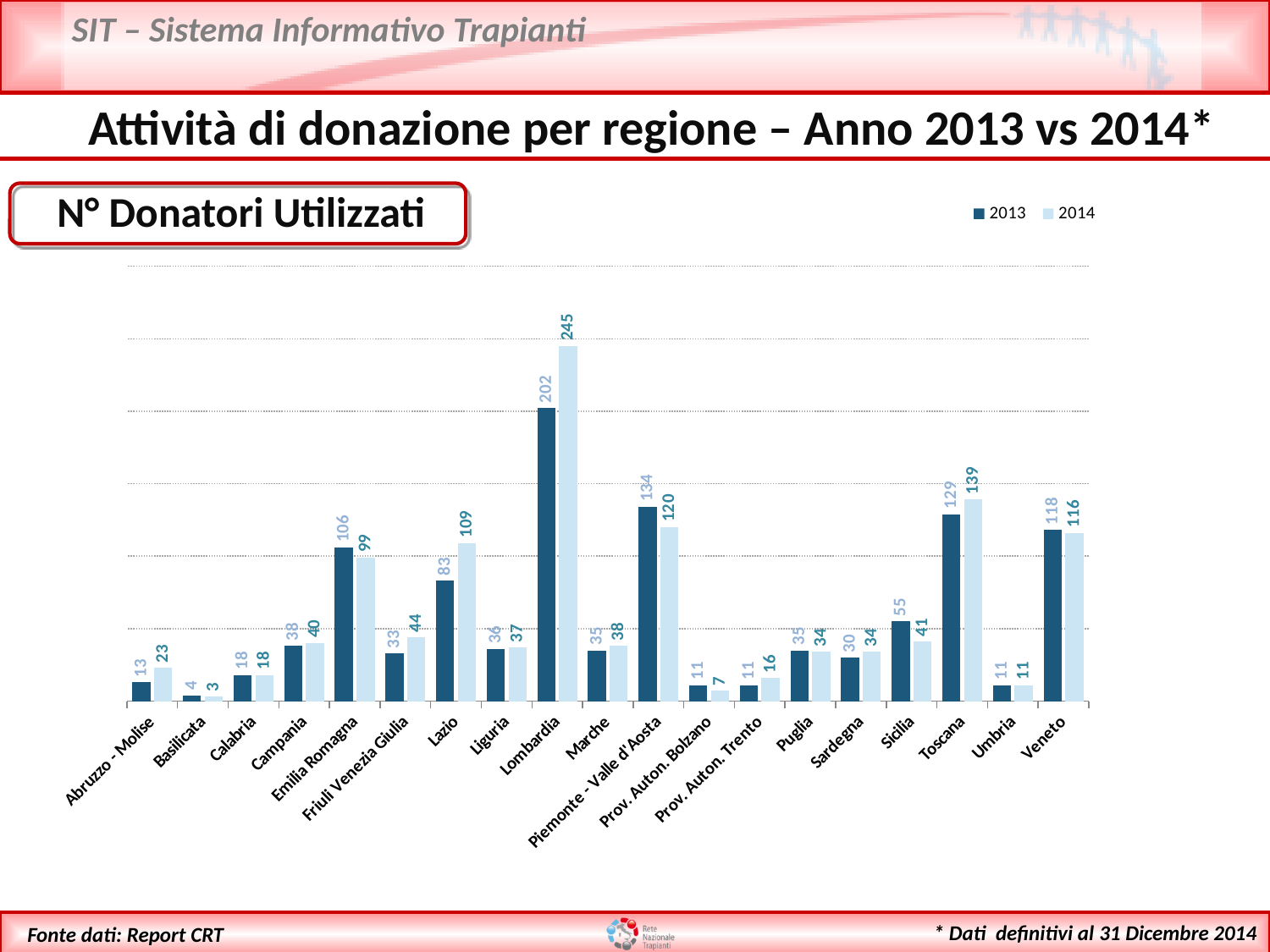
How many regions are shown on the x axis? 19 What is the difference between the 2014 and 2013 values for Lombardia? 43 What is the value for Lazio in 2013? 83 What is the value for Lombardia in 2014? 245 Which is larger for Sicilia, the 2013 value or the 2014 value? 2013 What is the difference between the 2013 and 2014 values for Piemonte - Valle d'Aosta? 14 Which region has the lowest value in 2014? Basilicata Which region has the highest value in 2013? Lombardia How many series does the legend list? 2 What is the value for Toscana in 2014? 139 What kind of chart is shown on the slide? Bar chart What is the title shown in the box above the chart? N° Donatori Utilizzati